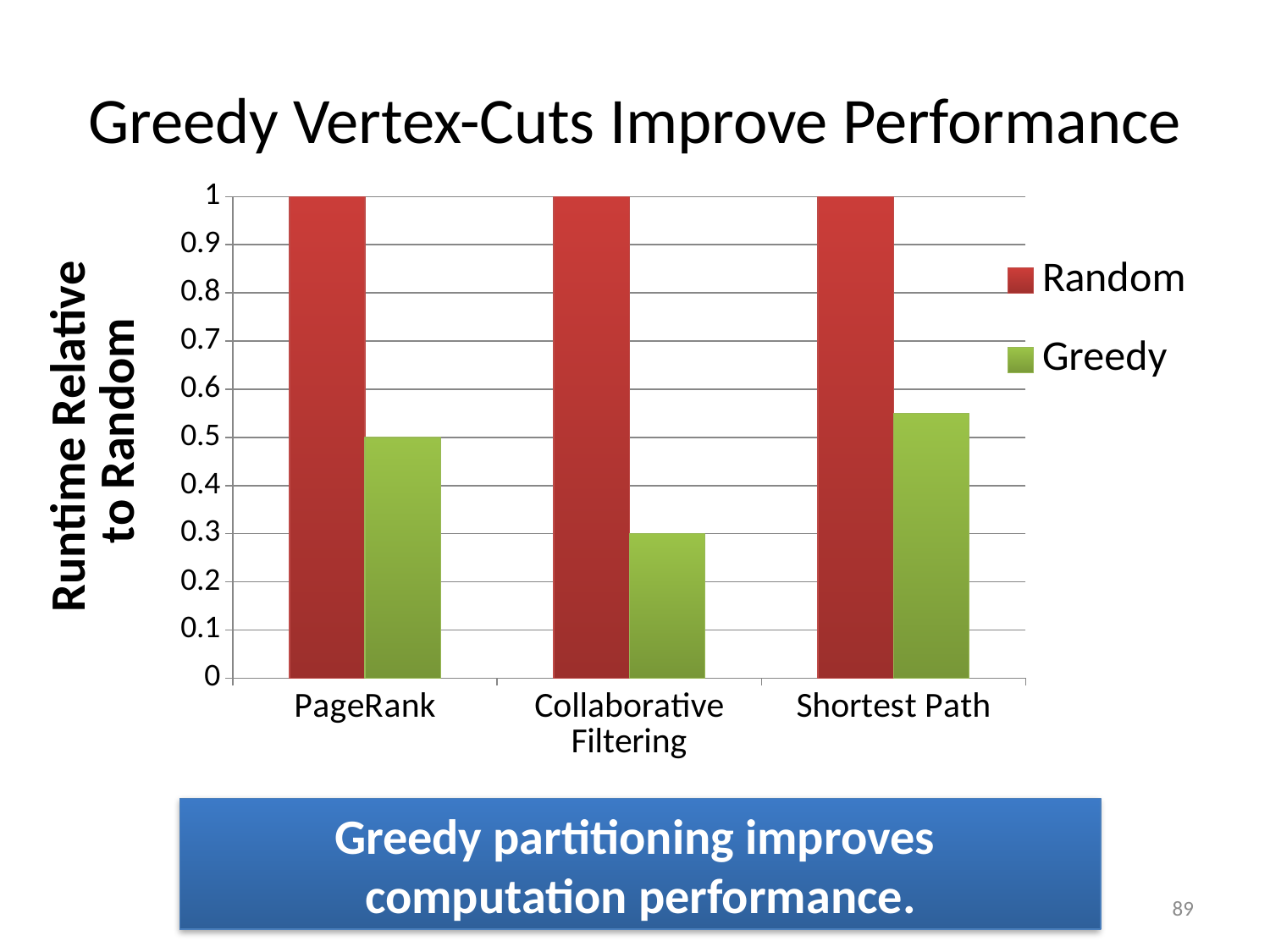
What is the difference between the Random and Greedy values for Collaborative Filtering? 0.7 How many series does the legend list? 2 Is the Greedy value for Shortest Path greater or less than 0.5? greater Which category has the highest Greedy value? Shortest Path Is the Greedy value for Shortest Path greater or less than 0.6? less What is the label of the y axis? Runtime Relative to Random Which category has the lowest Greedy value? Collaborative Filtering How many categories are shown on the x axis? 3 What is the Greedy value for Collaborative Filtering? 0.3 What type of chart is shown on the slide? bar chart What is the Greedy value for PageRank? 0.5 What is the Random value for Shortest Path? 1